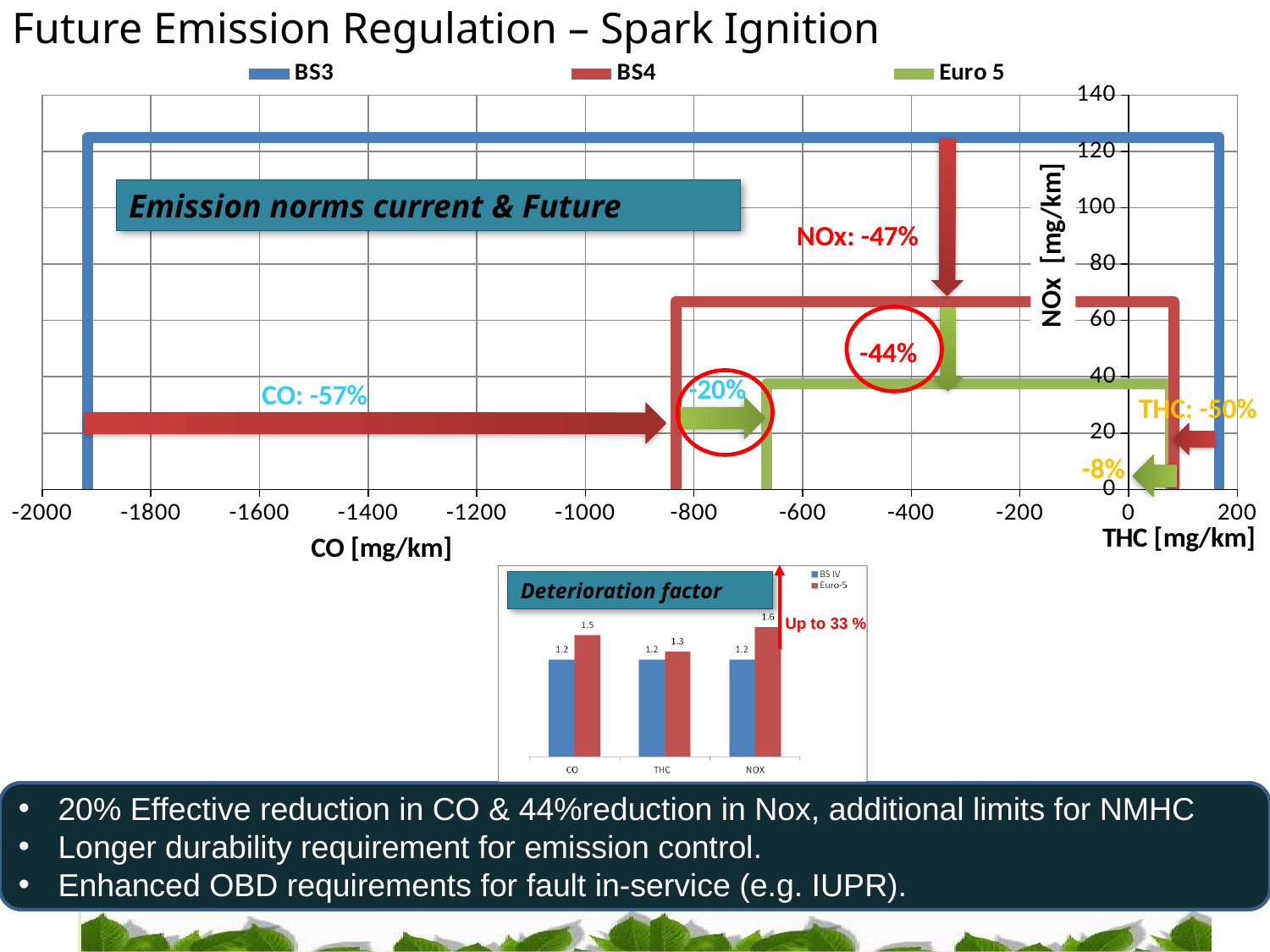
In the Deterioration factor chart, what is the Euro-5 value for THC? 1.3 In the Deterioration factor chart, what is the Euro-5 value for NOx? 1.6 In the Deterioration factor chart, what is the difference between the Euro-5 and BS IV values for NOx? 0.4 In the Emission norms current & Future chart, what percentage reduction is annotated for CO? -57% In the Deterioration factor chart, which is larger for CO: the BS IV value or the Euro-5 value? Euro-5 In the Deterioration factor chart, what is the BS IV value for CO? 1.2 In the Deterioration factor chart, which category has the lowest Euro-5 value? THC In the Deterioration factor chart, how many series does the legend list? 2 In the Emission norms current & Future chart, how many series does the legend list? 3 In the Deterioration factor chart, what kind of chart is shown? bar chart In the Deterioration factor chart, how many categories are shown on the x axis? 3 In the Deterioration factor chart, which category has the highest Euro-5 value? NOx